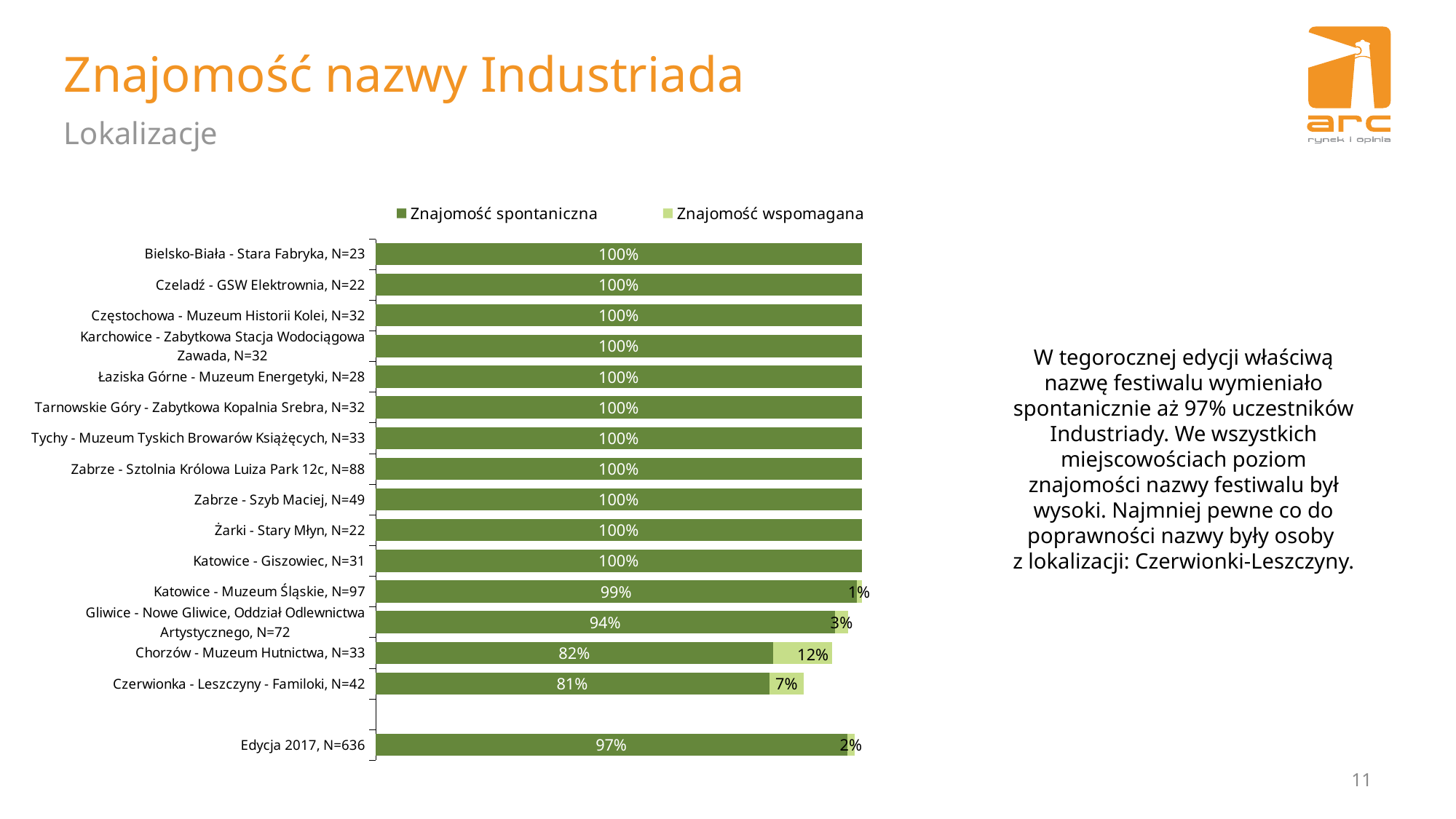
Which category has the highest value of Znajomość wspomagana? Chorzów - Muzeum Hutnictwa, N=33 Which has a higher value of Znajomość spontaniczna: Katowice - Muzeum Śląskie, N=97 or Gliwice - Nowe Gliwice, Oddział Odlewnictwa Artystycznego, N=72? Katowice - Muzeum Śląskie, N=97 What is the value of Znajomość spontaniczna for Czerwionka - Leszczyny - Familoki, N=42? 81% What is the value of Znajomość wspomagana for Gliwice - Nowe Gliwice, Oddział Odlewnictwa Artystycznego, N=72? 3% How many series does the legend list? 2 What kind of chart is shown on the slide? Stacked horizontal bar chart What is the value of Znajomość spontaniczna for Edycja 2017, N=636? 97% What are the two legend entries of the chart? Znajomość spontaniczna and Znajomość wspomagana What is the value of Znajomość wspomagana for Chorzów - Muzeum Hutnictwa, N=33? 12% What is the difference in Znajomość spontaniczna between Gliwice - Nowe Gliwice, Oddział Odlewnictwa Artystycznego, N=72 and Chorzów - Muzeum Hutnictwa, N=33? 12 percentage points What is the total of the stacked bar for Czerwionka - Leszczyny - Familoki, N=42? 88% Which category has the lowest value of Znajomość spontaniczna? Czerwionka - Leszczyny - Familoki, N=42